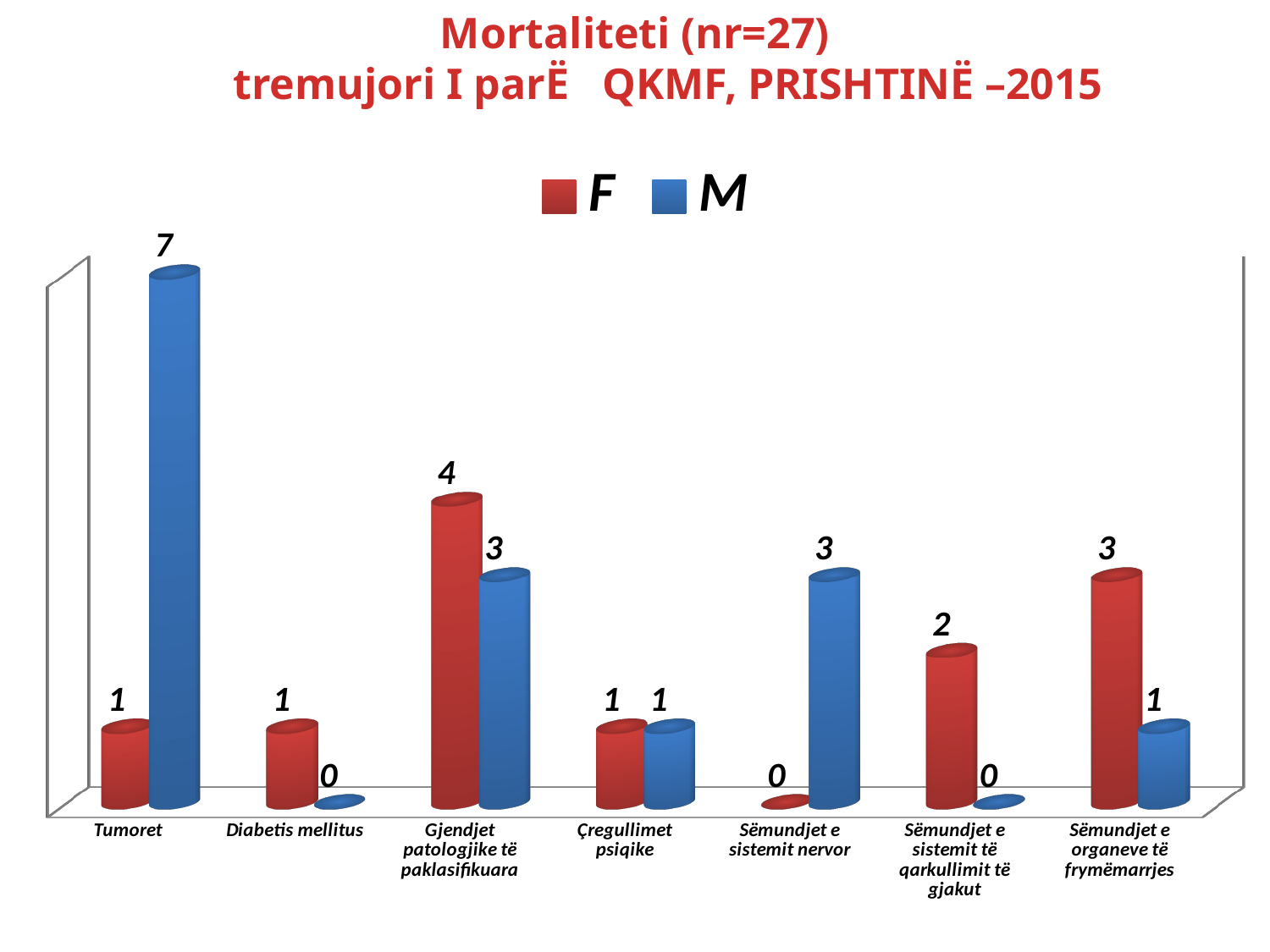
What is the F value for Sëmundjet e sistemit të qarkullimit të gjakut? 2 What is the difference between the M and F values for Tumoret? 6 Which category has the highest M value? Tumoret What kind of chart is shown on the slide? Bar chart Which category has the highest F value? Gjendjet patologjike të paklasifikuara What is the F value for Gjendjet patologjike të paklasifikuara? 4 What is the M value for Tumoret? 7 What is the M value for Diabetis mellitus? 0 Which is larger for Sëmundjet e organeve të frymëmarrjes, the F value or the M value? F Which colour represents the M series in the legend? Blue How many series does the legend list? 2 How many categories are shown on the x axis? 7